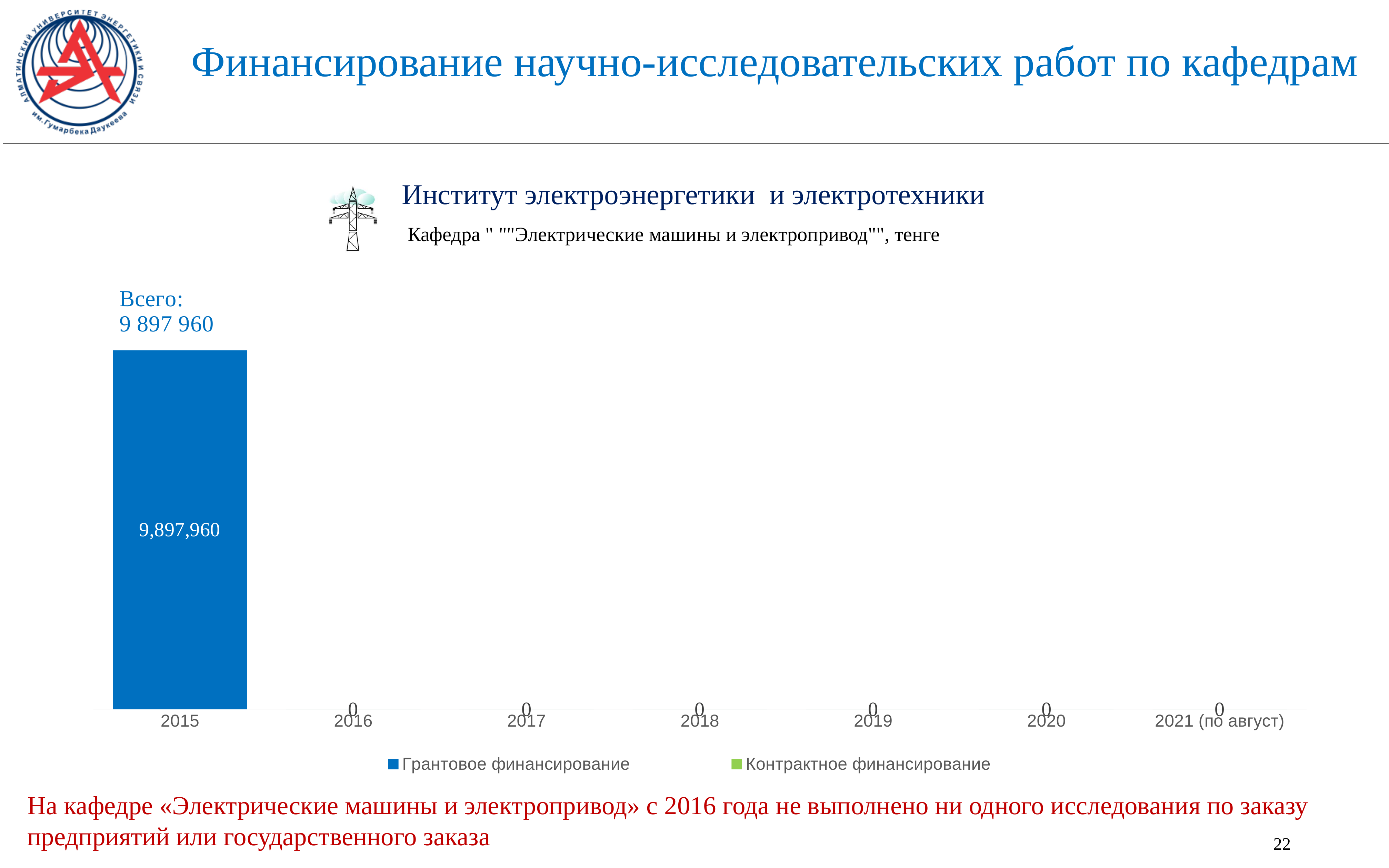
What is the label of the last category on the x axis? 2021 (по август) How many year categories are shown on the x axis? 7 Do the values rise or fall from 2015 to 2016? fall How many series does the legend list? 2 What kind of chart is shown on the slide? bar chart What total (Всего) is printed above the chart? 9 897 960 What value is shown for 2018? 0 Which is larger, the value for 2015 or the value for 2020? 2015 Which year has the highest value on the chart? 2015 What is the value of grant funding (Грантовое финансирование) for 2015? 9,897,960 Which series is shown in blue in the legend? Грантовое финансирование What is the difference between the value for 2015 and the value for 2016? 9,897,960